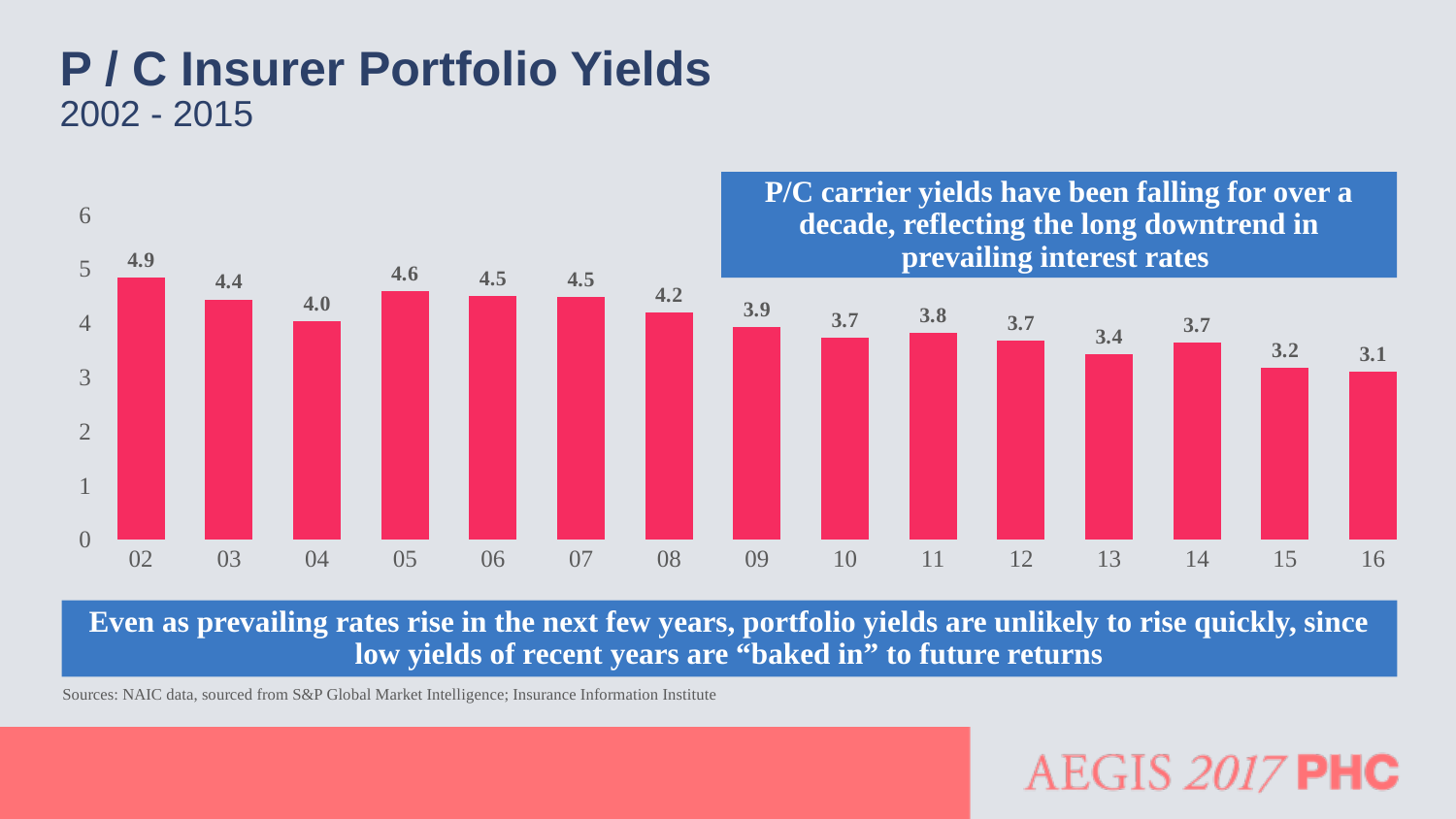
What is the title of the slide's chart? P / C Insurer Portfolio Yields What is the portfolio yield shown for 02? 4.9 Do the portfolio yields generally rise or fall from 02 to 16? fall Which year has the highest portfolio yield? 02 Is the value for 13 greater or less than 4? less What is the portfolio yield shown for 16? 3.1 What is the portfolio yield shown for 10? 3.7 What kind of chart is shown on the slide? bar chart How many years are plotted on the chart? 15 What is the difference between the yield for 02 and the yield for 16? 1.8 Which year has the lowest portfolio yield? 16 Which is larger, the yield for 05 or the yield for 08? 05